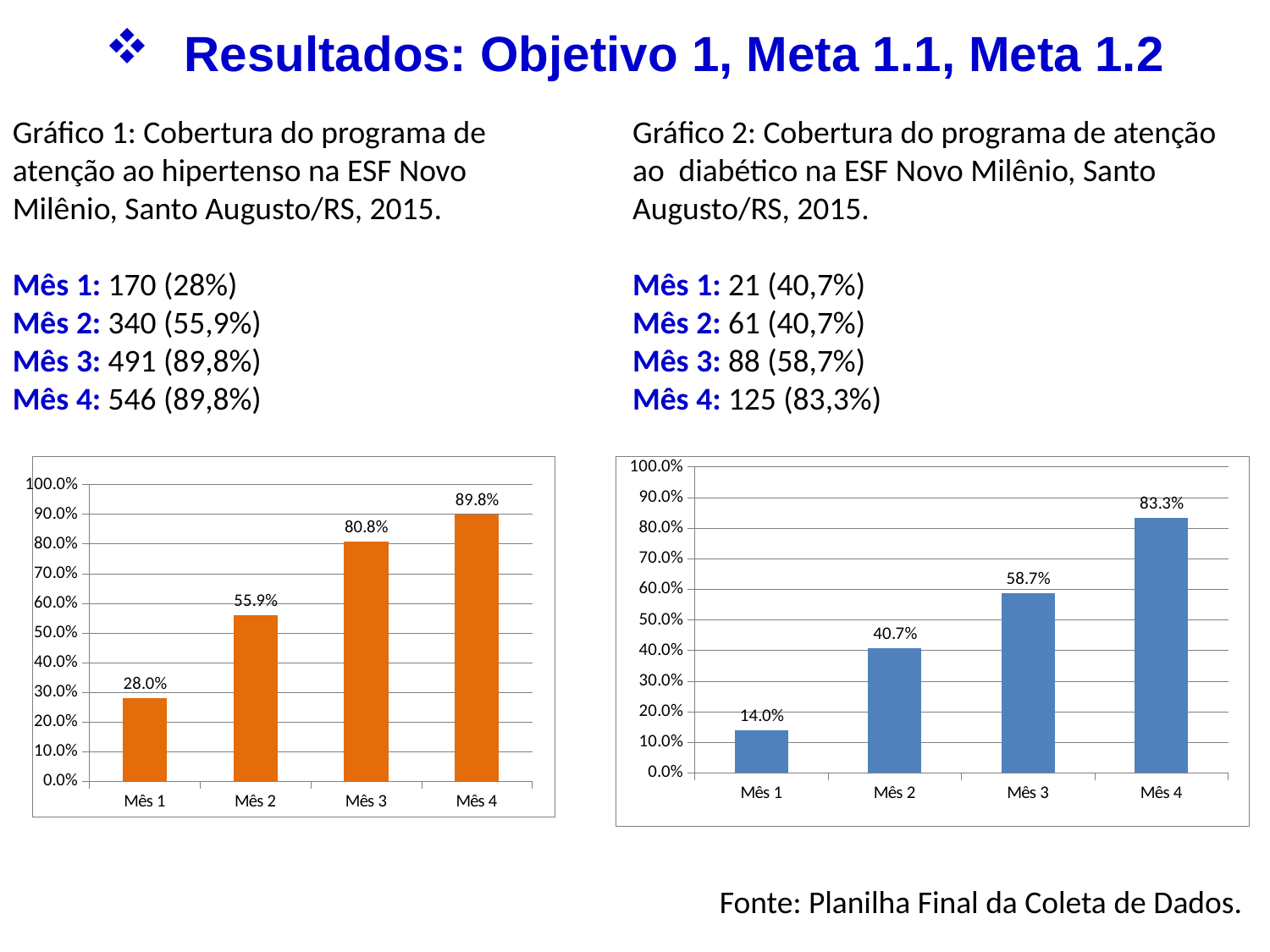
What type of chart is the left chart (Gráfico 1, hipertenso)? Bar chart In the left chart (Gráfico 1, hipertenso), what is the difference between the values for Mês 4 and Mês 1? 61.8% In the right chart (Gráfico 2, diabético), what is the value for Mês 4? 83.3% In the left chart (Gráfico 1, hipertenso), what is the value for Mês 3? 80.8% How many bars does the right chart (Gráfico 2, diabético) have? 4 In the right chart (Gráfico 2, diabético), do the values rise or fall from Mês 1 to Mês 4? Rise In the left chart (Gráfico 1, hipertenso), what is the value for Mês 2? 55.9% Which is larger: the Mês 2 value in the left chart or the Mês 2 value in the right chart? The left chart (55.9%) In the right chart (Gráfico 2, diabético), what is the difference between the values for Mês 3 and Mês 2? 18.0% In the left chart (Gráfico 1, hipertenso), which month has the highest value? Mês 4 In the right chart (Gráfico 2, diabético), which month has the lowest value? Mês 1 In the right chart (Gráfico 2, diabético), what is the value for Mês 1? 14.0%